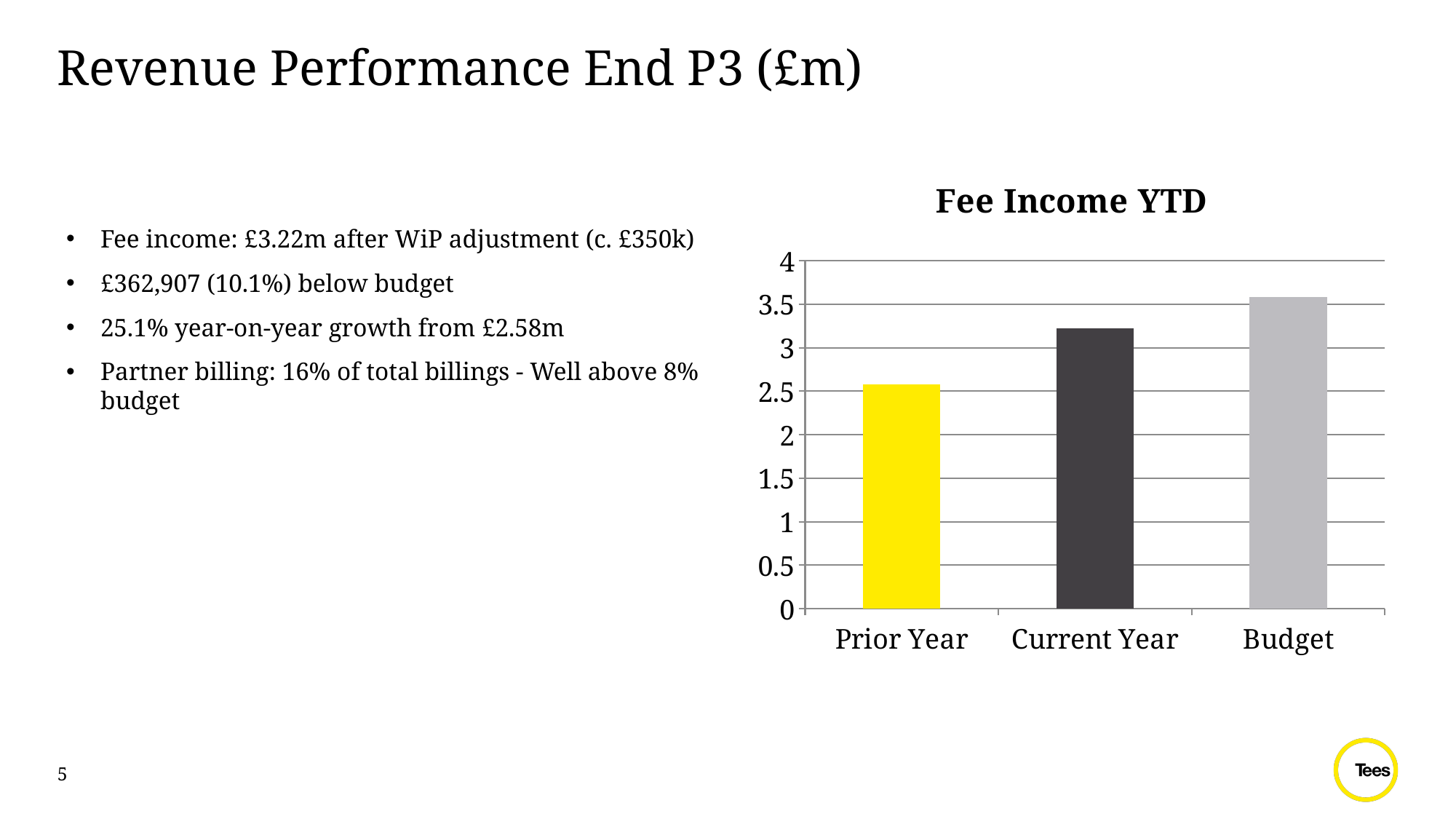
Is the value for Current Year greater or less than 3? greater What is the title of the chart? Fee Income YTD What colour is the Prior Year bar? yellow Which category has the lowest bar in the chart? Prior Year Which is larger, the value for Current Year or the value for Prior Year? Current Year Which category has the highest bar in the chart? Budget Is the value for Prior Year greater or less than 3? less Do the bar values rise or fall from left to right across the x axis? rise Is the value for Budget greater or less than 3? greater How many categories are shown on the x axis of the chart? 3 What kind of chart is shown on the slide? bar chart